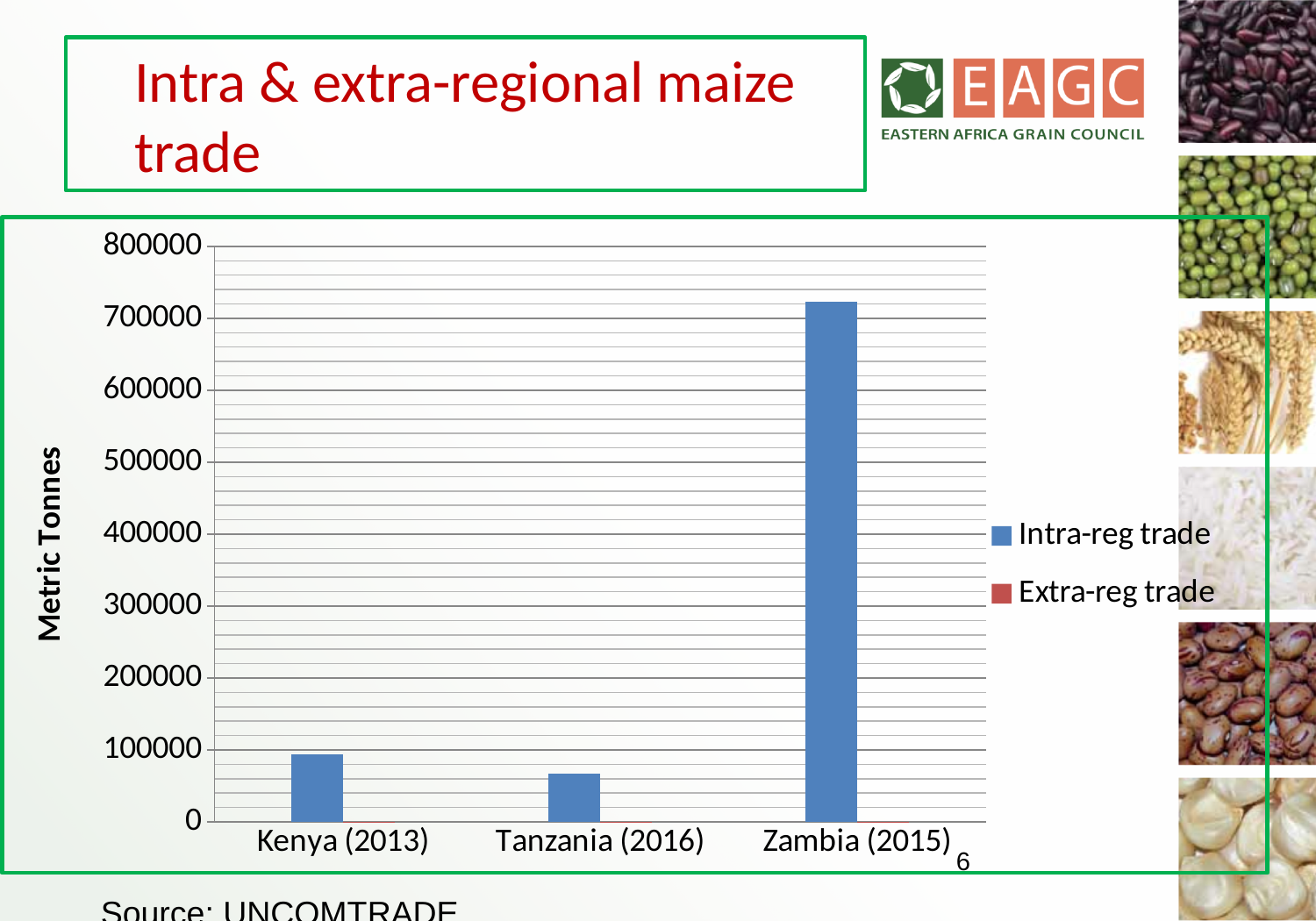
Is the Intra-reg trade value for Zambia (2015) greater or less than 700000? greater How many series does the chart's legend list? 2 What kind of chart is shown on the slide? Bar chart What is the label on the vertical axis of the chart? Metric Tonnes Is the Intra-reg trade value for Kenya (2013) greater or less than 100000? less Which has a larger Intra-reg trade value, Kenya (2013) or Tanzania (2016)? Kenya (2013) Which category has the highest Intra-reg trade value? Zambia (2015) Which has a larger Intra-reg trade value, Zambia (2015) or Kenya (2013)? Zambia (2015) Which category has the lowest Intra-reg trade value? Tanzania (2016) How many categories are shown on the x axis of the chart? 3 Is the Intra-reg trade value for Tanzania (2016) greater or less than 100000? less What are the two series named in the chart's legend? Intra-reg trade and Extra-reg trade